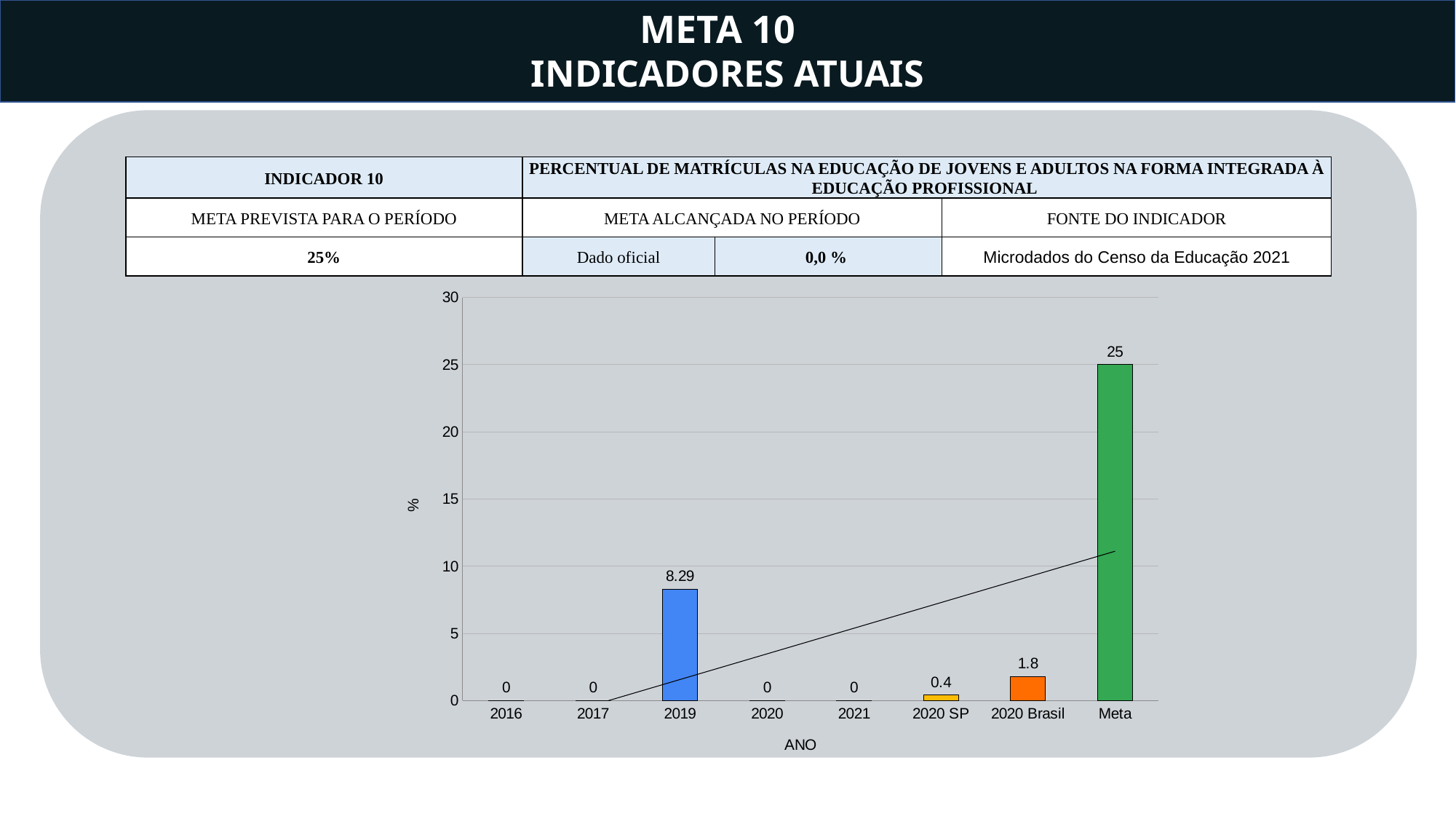
What is the value shown for 2020 Brasil in the chart? 1.8 What is the value shown for 2020 SP in the chart? 0.4 Is the value for 2019 greater or less than 10? less What is the difference between the 2020 Brasil value and the 2020 SP value? 1.4 What is the difference between the Meta value and the 2019 value? 16.71 What is the value shown for 2021 in the chart? 0 What kind of chart is shown on the slide? bar chart Which category has the highest value in the chart? Meta What is the value shown for 2019 in the chart? 8.29 Which is larger, the value for 2019 or the value for 2020 Brasil? 2019 What is the value shown for Meta in the chart? 25 How many categories are shown on the x axis of the chart? 8